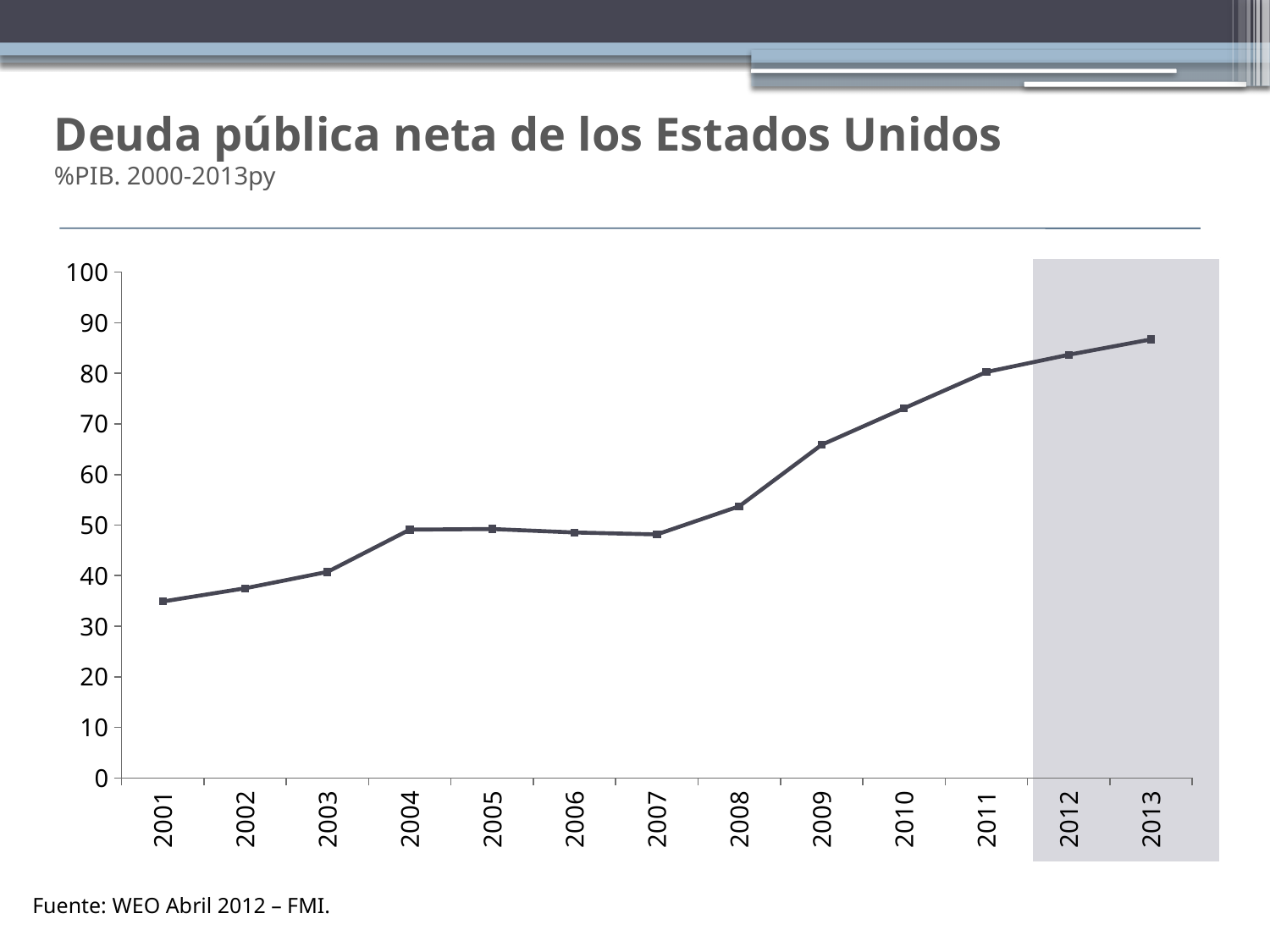
Is the value for 2010 greater or less than 70? greater Do the values generally rise or fall from 2001 to 2013? rise How many years are plotted on the x axis? 13 What kind of chart is shown on the slide? line chart Is the value for 2001 greater or less than 40? less Is the value for 2013 greater or less than 80? greater Which year has the lowest value? 2001 What is the title of the chart on the slide? Deuda pública neta de los Estados Unidos Which year has the highest value? 2013 Which is larger, the value for 2009 or the value for 2007? 2009